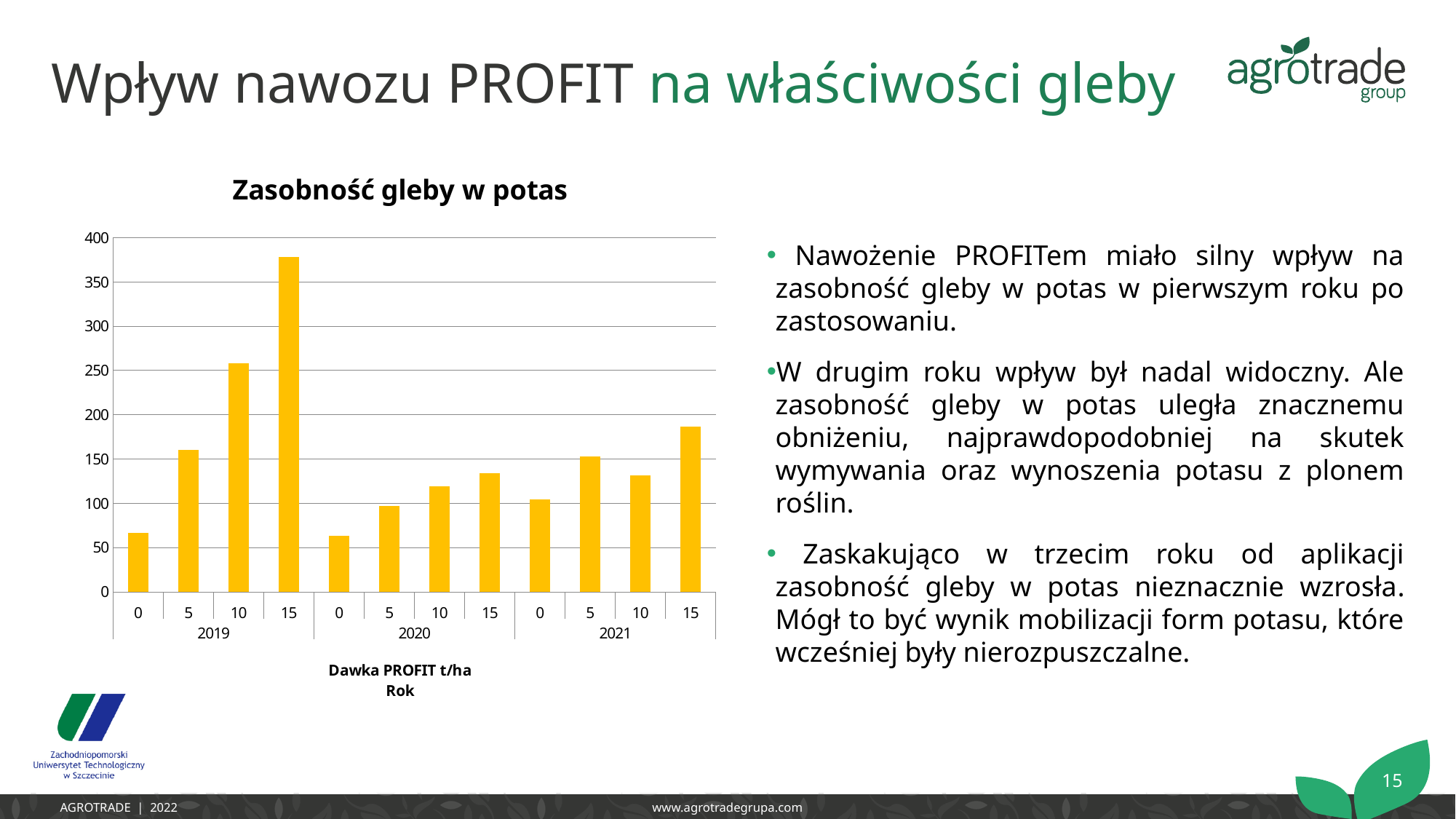
Is the value for dose 10 in 2019 greater or less than 200? greater What type of chart is shown on the slide? bar chart What is the title of the chart? Zasobność gleby w potas How many bars are plotted in the chart? 12 Which is larger: the value for dose 10 in 2019 or the value for dose 15 in 2021? dose 10 in 2019 Is the value for dose 0 in 2020 greater or less than 100? less Is the value for dose 15 in 2021 greater or less than 200? less Which bar has the highest value in the chart? 15 in 2019 Within 2021, which dose has the lowest value? 0 Within 2019, do the values rise or fall as the PROFIT dose increases from 0 to 15? rise